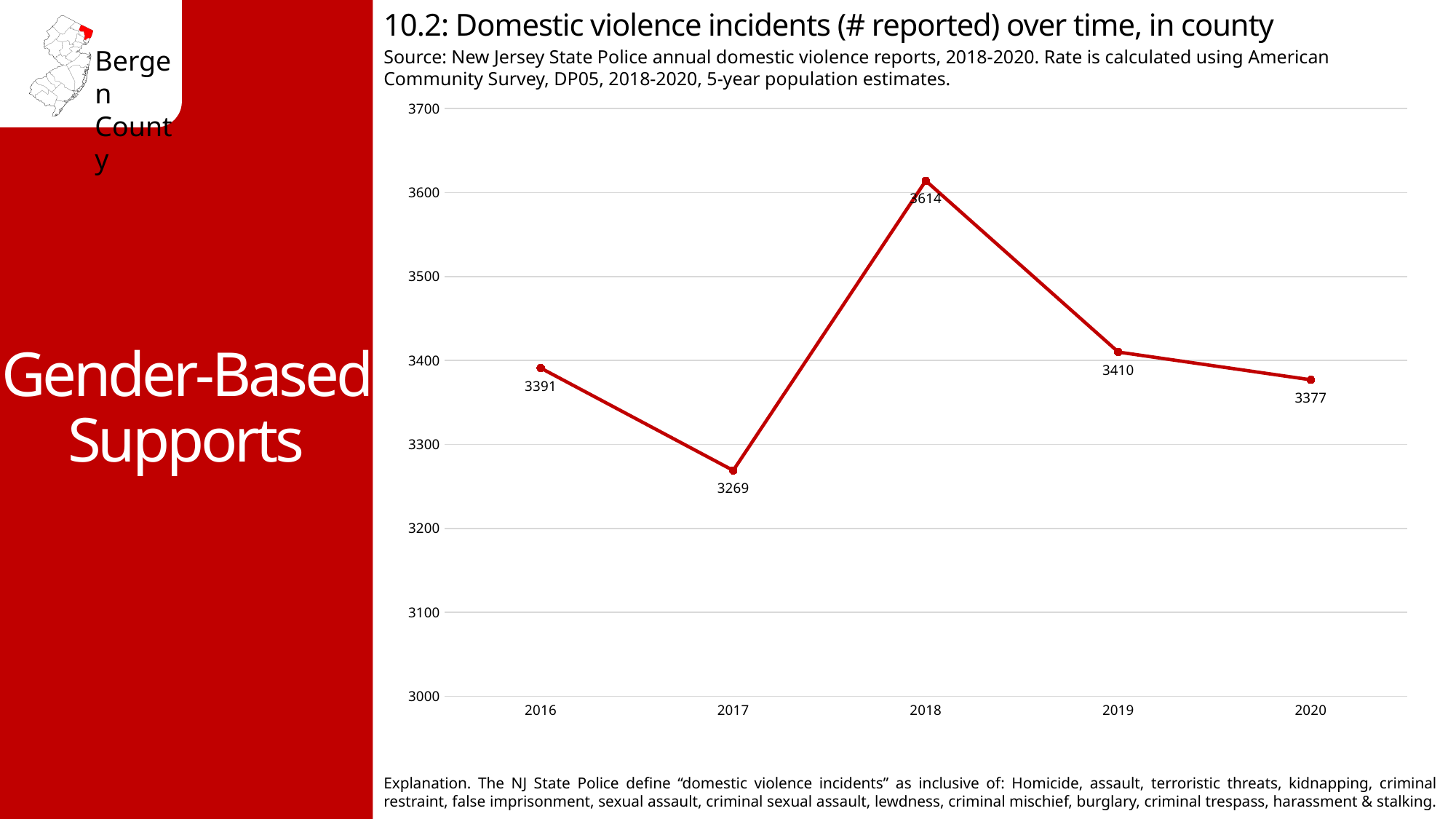
Which year had the highest number of reported domestic violence incidents? 2018 What kind of chart is shown on the slide? line chart What was the number of reported domestic violence incidents in 2020? 3377 What was the number of reported domestic violence incidents in 2018? 3614 Which year had the lowest number of reported domestic violence incidents? 2017 What is the difference between the number of incidents in 2018 and in 2017? 345 What was the number of reported domestic violence incidents in 2016? 3391 Did the number of reported incidents rise or fall from 2018 to 2020? fall Is the value for 2017 greater or less than 3300? less How many years are plotted on the chart? 5 Which year had more reported incidents, 2016 or 2019? 2019 What is the difference between the number of incidents in 2019 and in 2020? 33